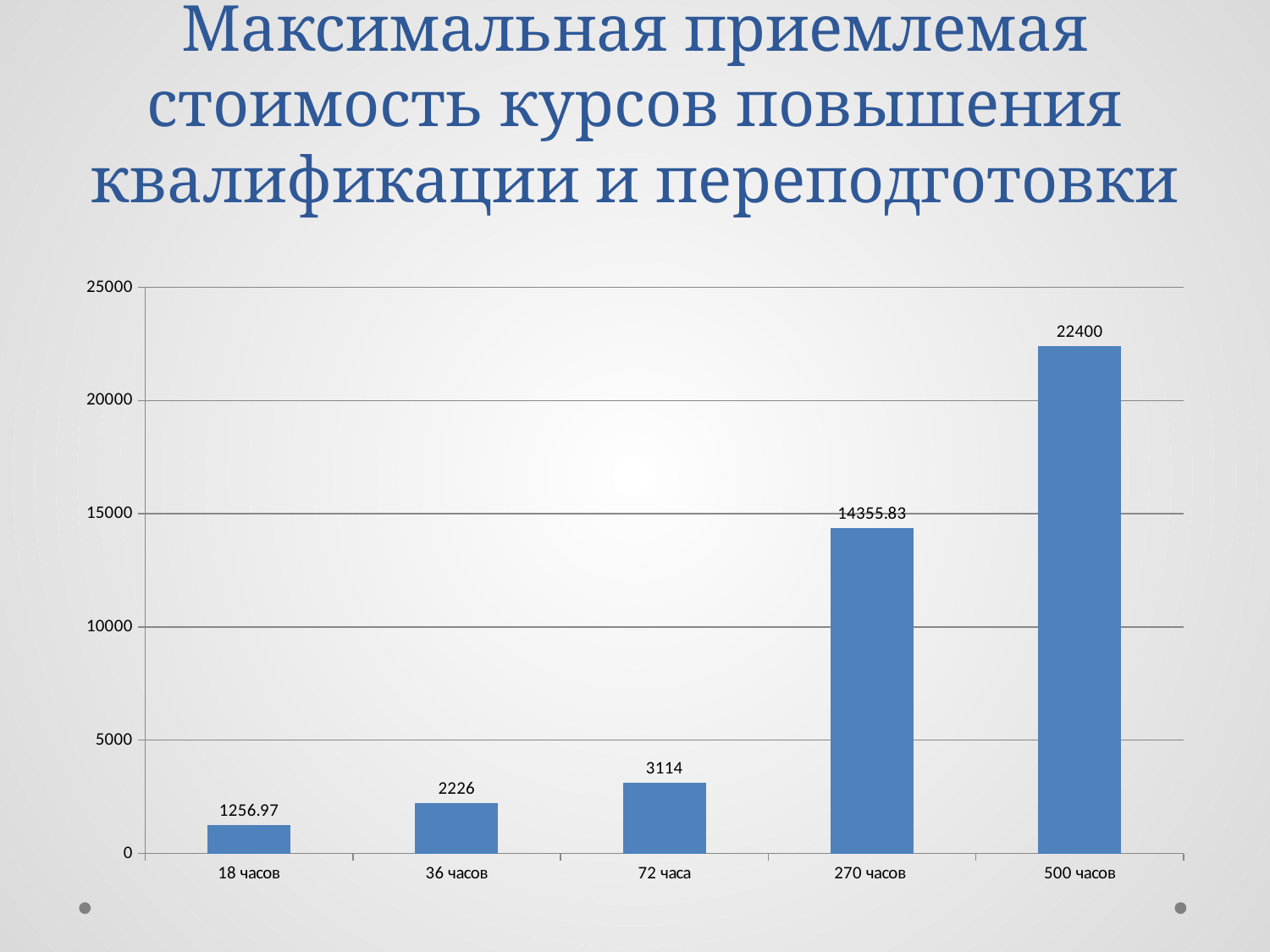
Is the value for 270 часов greater or less than 15000? less Do the values rise or fall from left to right along the x axis? rise How many categories are shown on the x axis? 5 Which category has the lowest value? 18 часов Which is larger, the value for 72 часа or the value for 36 часов? 72 часа What is the value for 500 часов? 22400 What is the value for 270 часов? 14355.83 Which category has the highest value? 500 часов What kind of chart is shown on the slide? bar chart What is the value for 18 часов? 1256.97 What is the difference between the values for 72 часа and 36 часов? 888 What is the difference between the values for 500 часов and 270 часов? 8044.17